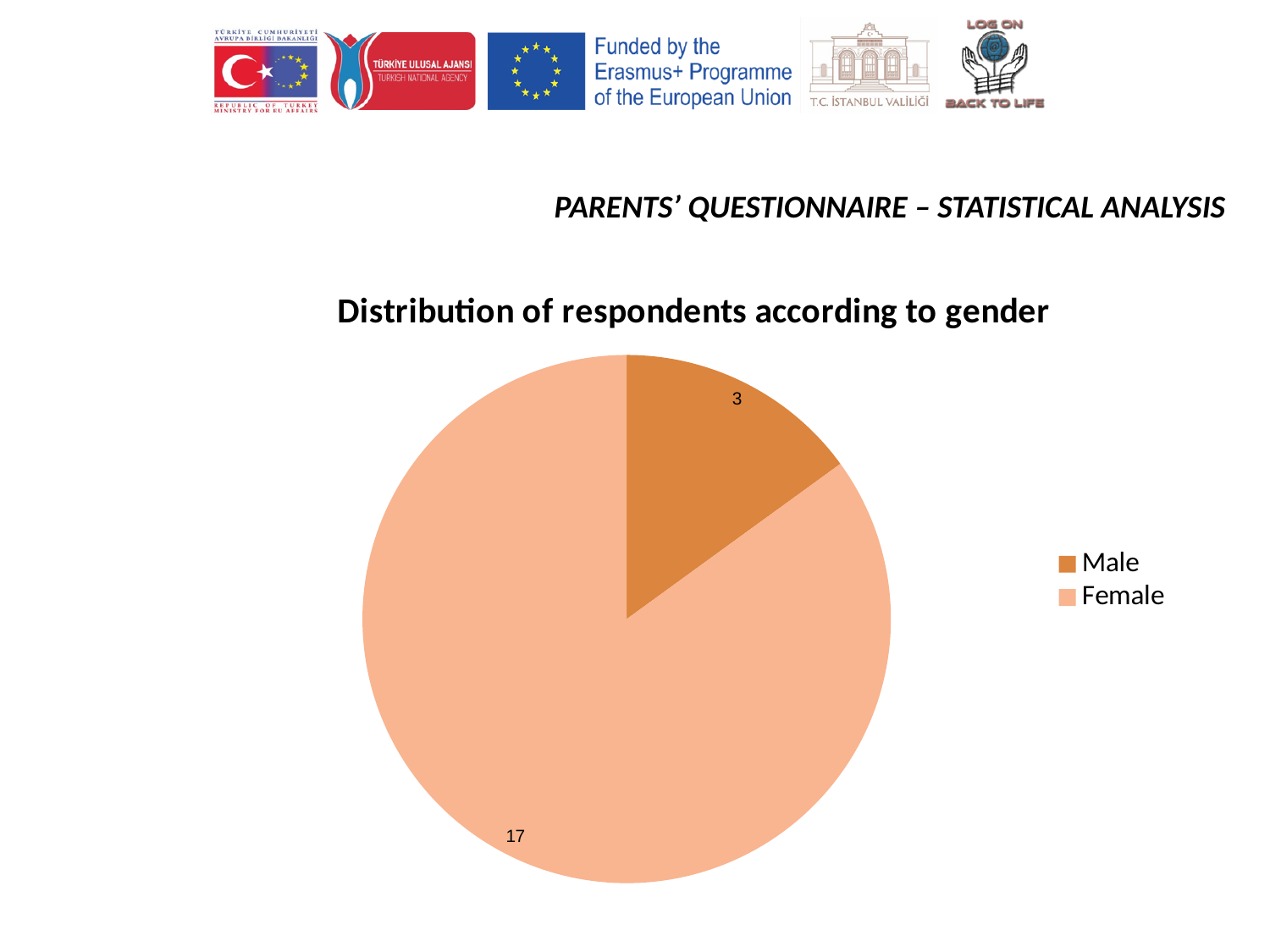
Which category has the smallest slice of the pie? Male What is the title of the chart? Distribution of respondents according to gender Which category has the largest slice of the pie? Female What is the total of all slices in the pie chart? 20 What is the value for Female? 17 Which is larger, the value for Male or the value for Female? Female How many categories does the pie chart show? 2 How many entries does the legend list? 2 What kind of chart is shown on the slide? pie chart What is the value for Male? 3 What is the difference between the Female and Male values? 14 What share of the pie does the Female slice represent? 85%